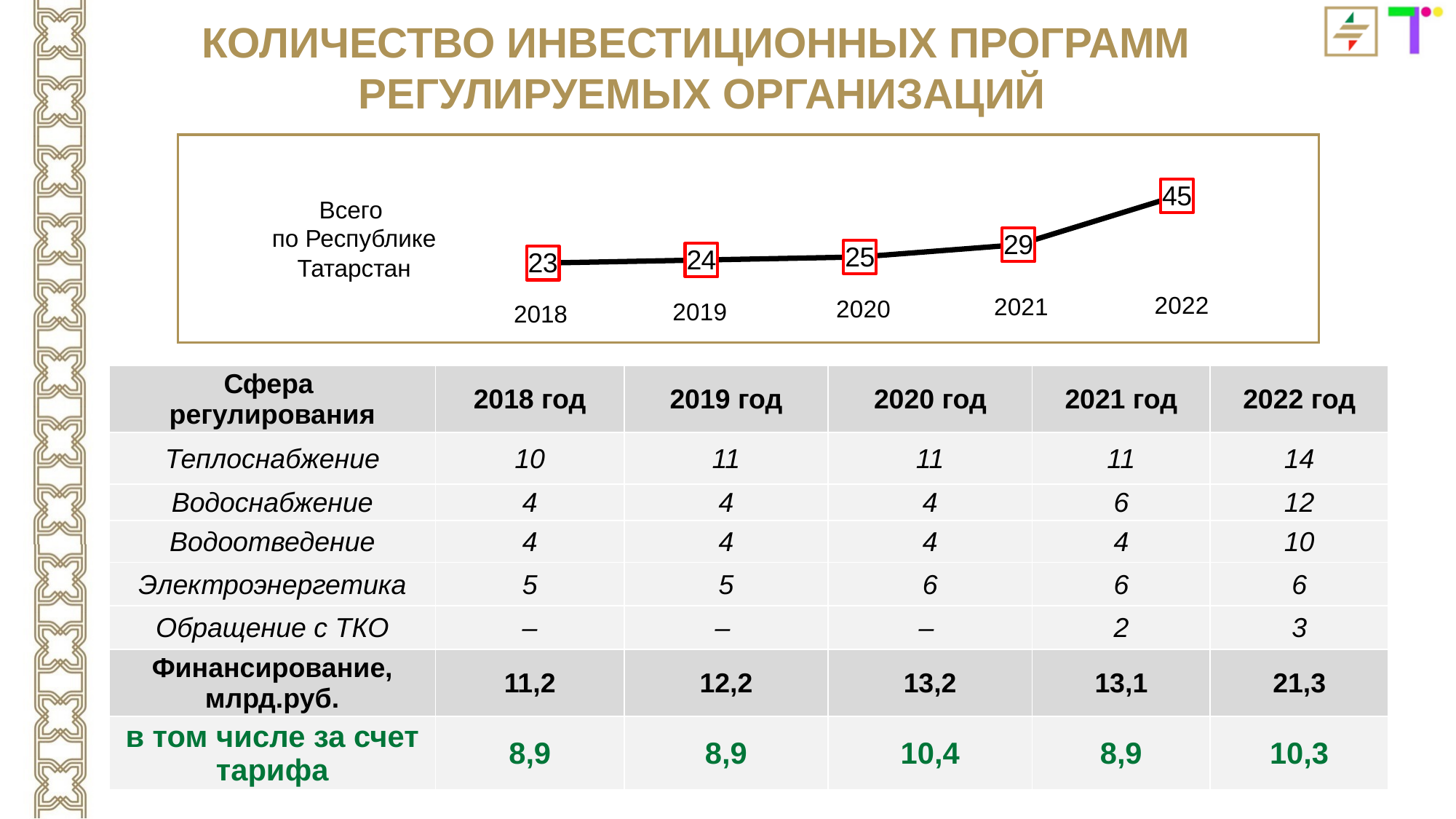
What type of chart is shown on the slide? line chart Which year has the highest value in the line chart? 2022 How many data points are plotted in the line chart? 5 Which year has the lowest value in the line chart? 2018 What is the value for 2021 in the line chart? 29 What is the value for 2018 in the line chart? 23 Do the values in the line chart rise or fall from 2018 to 2022? rise Which is larger in the line chart, the value for 2021 or the value for 2020? 2021 What is the difference between the values for 2022 and 2021 in the line chart? 16 What is the difference between the values for 2019 and 2018 in the line chart? 1 What is the value for 2020 in the line chart? 25 What is the value for 2022 in the line chart? 45